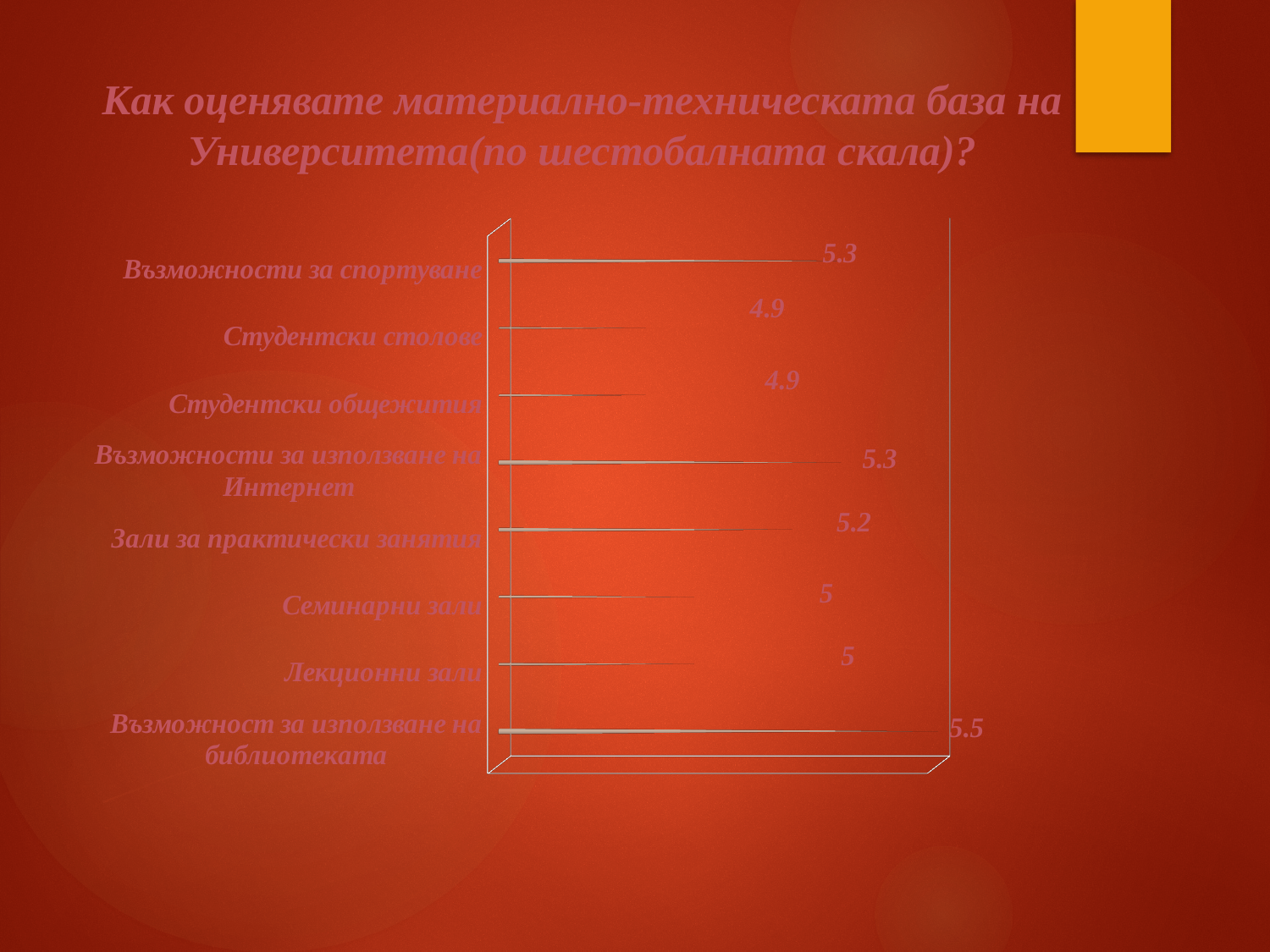
What kind of chart is shown on the slide? Bar chart What is the value for Студентски столове? 4.9 Which category has the highest value? Възможност за използване на библиотеката What is the value for Възможности за използване на Интернет? 5.3 What is the value for Семинарни зали? 5 How many categories are shown in the chart? 8 What is the value for Зали за практически занятия? 5.2 What is the difference between the values for Възможности за използване на Интернет and Зали за практически занятия? 0.1 What is the lowest value shown in the chart? 4.9 What is the value for Възможност за използване на библиотеката? 5.5 Which is larger, the value for Възможности за спортуване or the value for Лекционни зали? Възможности за спортуване What is the difference between the values for Възможност за използване на библиотеката and Студентски общежития? 0.6